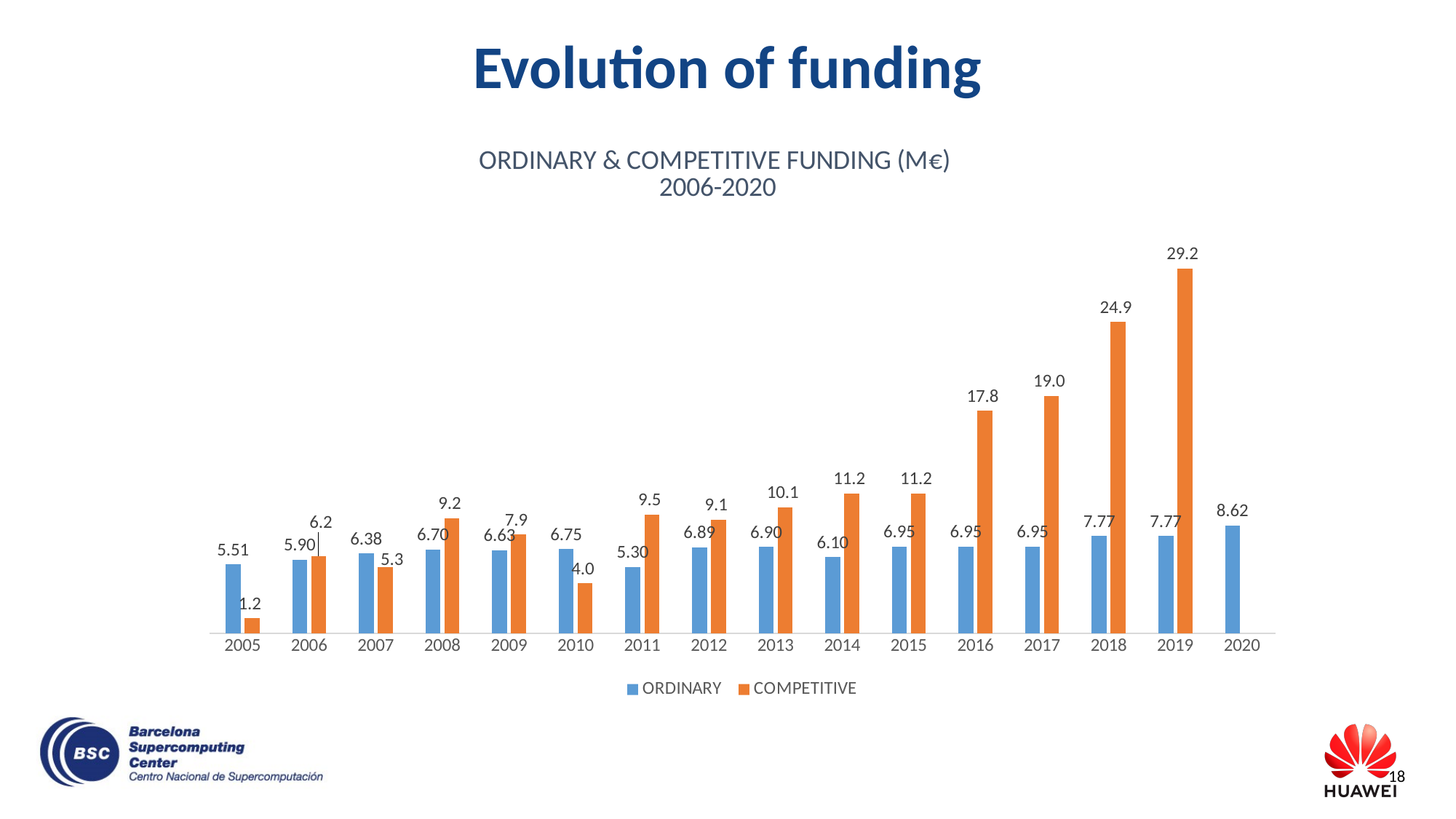
What is the ORDINARY funding value for 2020? 8.62 What is the COMPETITIVE funding value for 2010? 4.0 How many series does the legend list? 2 Which year has the lowest ORDINARY funding? 2011 Which year has the highest COMPETITIVE funding? 2019 What is the COMPETITIVE funding value for 2019? 29.2 How many years are shown on the x axis? 16 Which is larger in 2007, ORDINARY or COMPETITIVE funding? ORDINARY What kind of chart is shown on the slide? Bar chart Does COMPETITIVE funding rise or fall from 2015 to 2019? Rise What is the difference between COMPETITIVE funding in 2019 and 2018? 4.3 Which year has the lowest COMPETITIVE funding? 2005